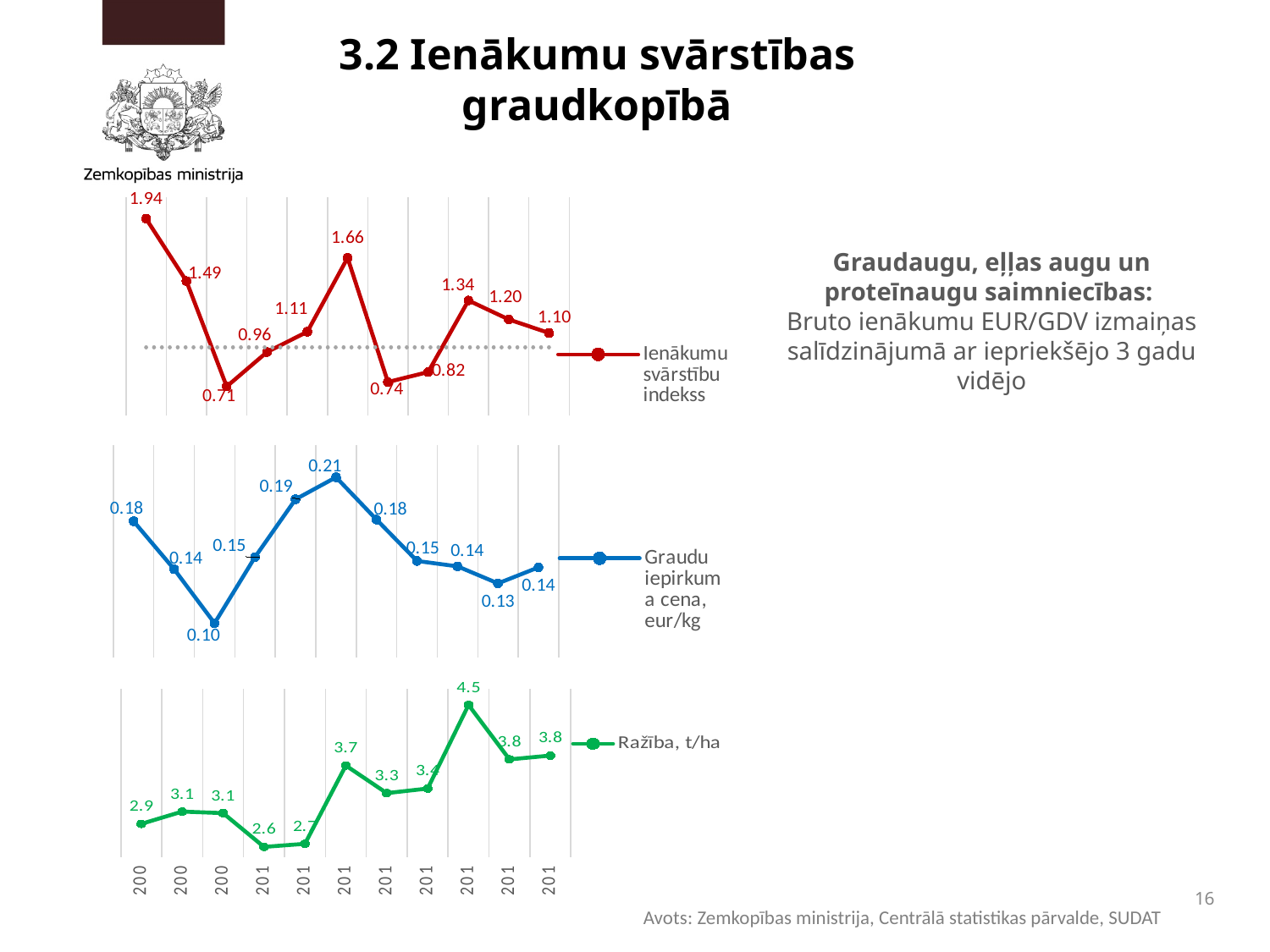
In the bottom chart (Ražība, t/ha), what is the highest value plotted? 4.5 How many data points are plotted in the middle chart (Graudu iepirkuma cena, eur/kg)? 11 What type of chart is the top chart (Ienākumu svārstību indekss)? line chart In the top chart (Ienākumu svārstību indekss), what is the value of the last (rightmost) point? 1.10 In the middle chart (Graudu iepirkuma cena, eur/kg), what is the lowest value plotted? 0.10 In the bottom chart (Ražība, t/ha), which is larger: the sixth point (3.7) or the seventh point (3.3)? the sixth point (3.7) In the bottom chart (Ražība, t/ha), what is the value of the first (leftmost) point? 2.9 In the top chart (Ienākumu svārstību indekss), what is the lowest value plotted? 0.71 In the middle chart (Graudu iepirkuma cena, eur/kg), what is the highest value plotted? 0.21 In the top chart (Ienākumu svārstību indekss), what is the difference between the first point (1.94) and the second point (1.49)? 0.45 How many series does the legend of the bottom chart list? 1 In the top chart (Ienākumu svārstību indekss), what is the highest value plotted? 1.94